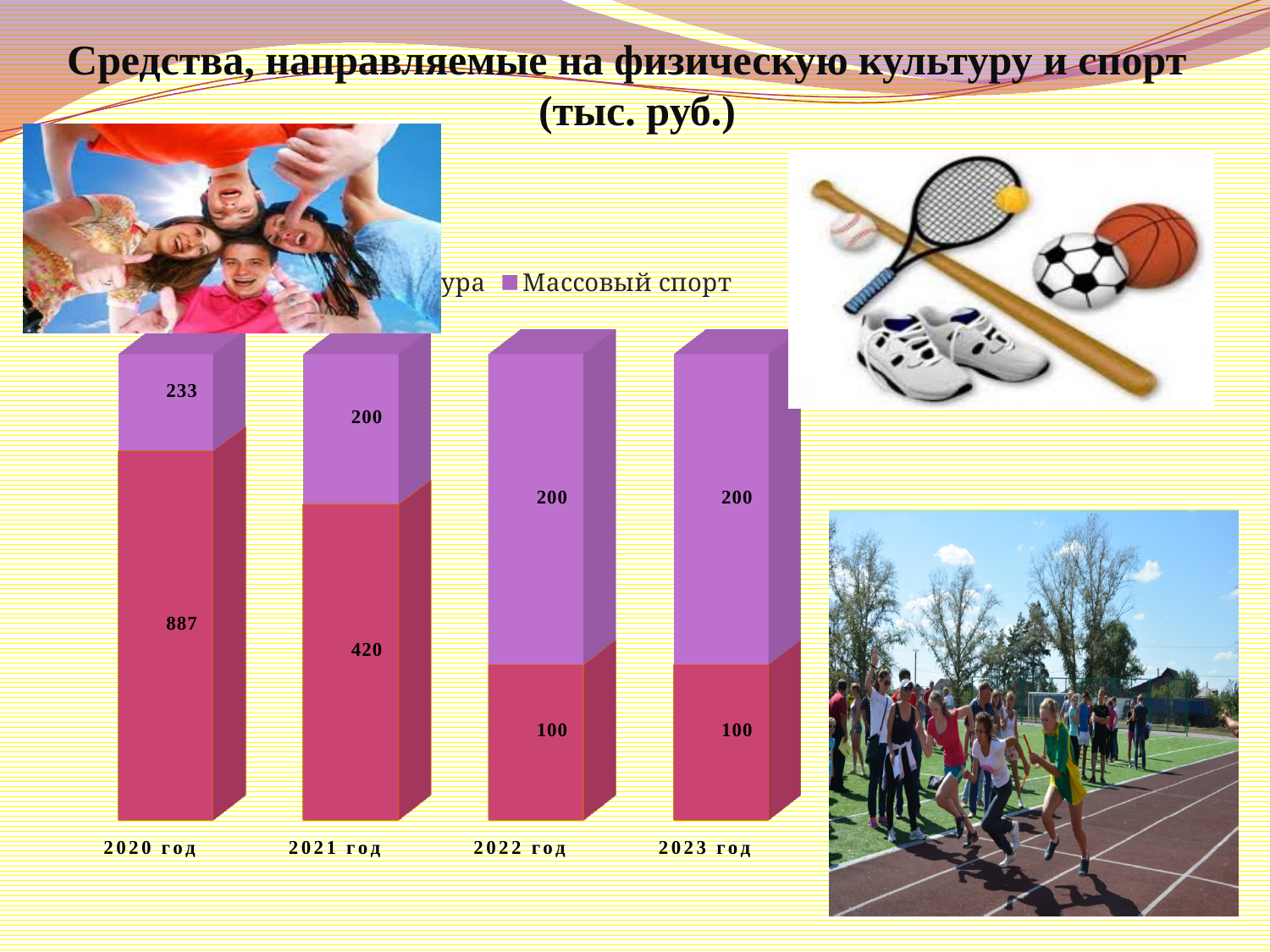
What is the value of the lower (red) segment of the bar for 2020 год? 887 What kind of chart is shown on the slide? bar chart What is the total of the stacked bar for 2021 год? 620 What is the total of the stacked bar for 2020 год? 1120 In which year is the value for Массовый спорт the highest? 2020 год Do the values of the lower (red) segment rise or fall from 2020 год to 2023 год? fall What is the value of the lower (red) segment of the bar for 2022 год? 100 What is the value for Массовый спорт in 2021 год? 200 What is the value for Массовый спорт in 2020 год? 233 What is the difference between the lower (red) segment values for 2020 год and 2021 год? 467 How many series does the chart's legend list? 2 How many years (categories) are shown on the x axis of the chart? 4